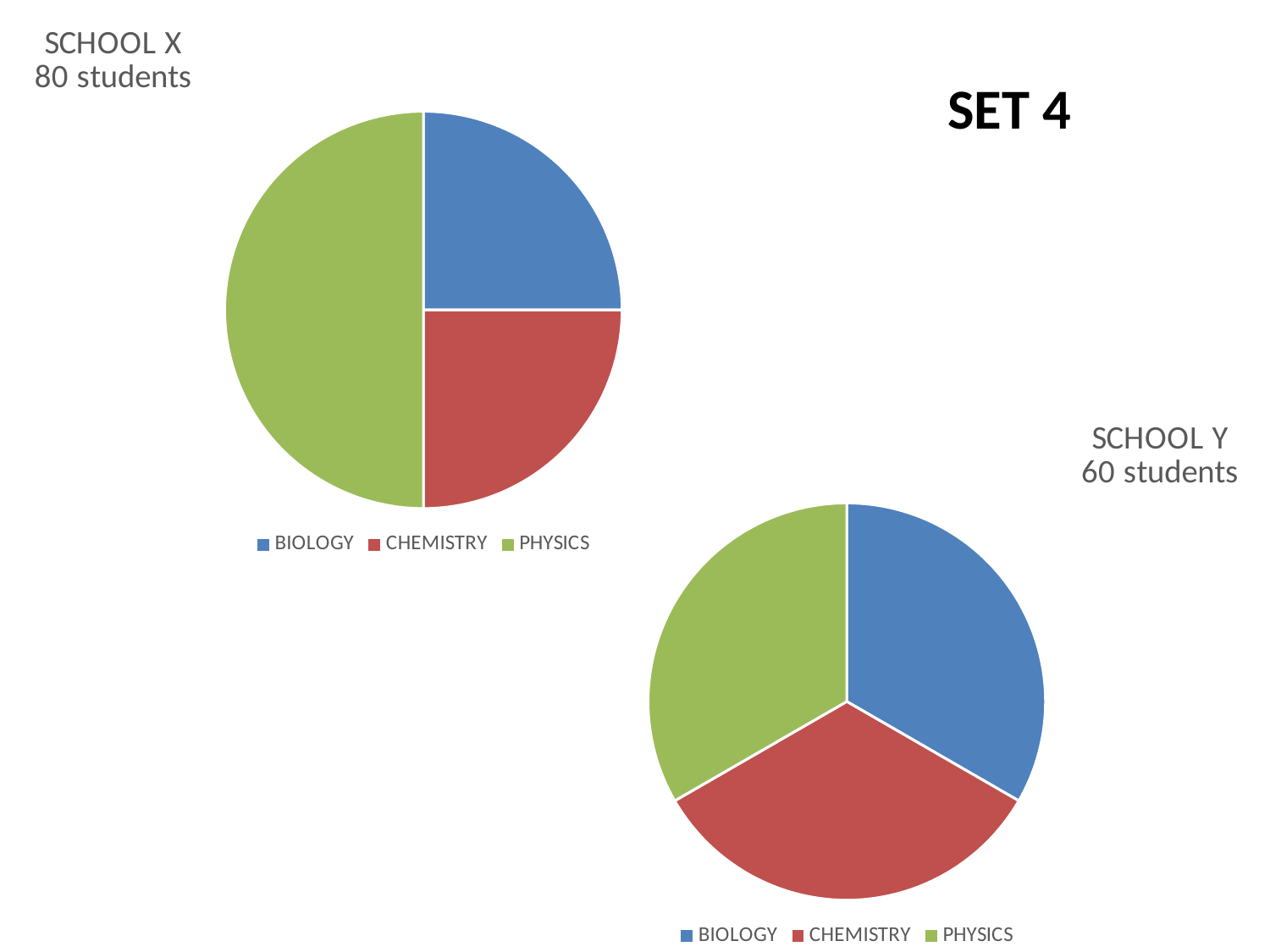
In the School X chart, how many entries does the legend list? 3 In the School X chart, how many slices does the pie have? 3 In the School Y chart, how many entries does the legend list? 3 What kind of chart is the School X chart? Pie chart In the School Y chart, how many slices does the pie have? 3 In the School X chart, which slice is larger, PHYSICS or BIOLOGY? PHYSICS What kind of chart is the School Y chart? Pie chart In the School X chart, which subject has the largest slice? PHYSICS In the School Y chart, which colour represents CHEMISTRY? Red How many students does the School X chart represent? 80 students In the School X chart, which slice is larger, PHYSICS or CHEMISTRY? PHYSICS